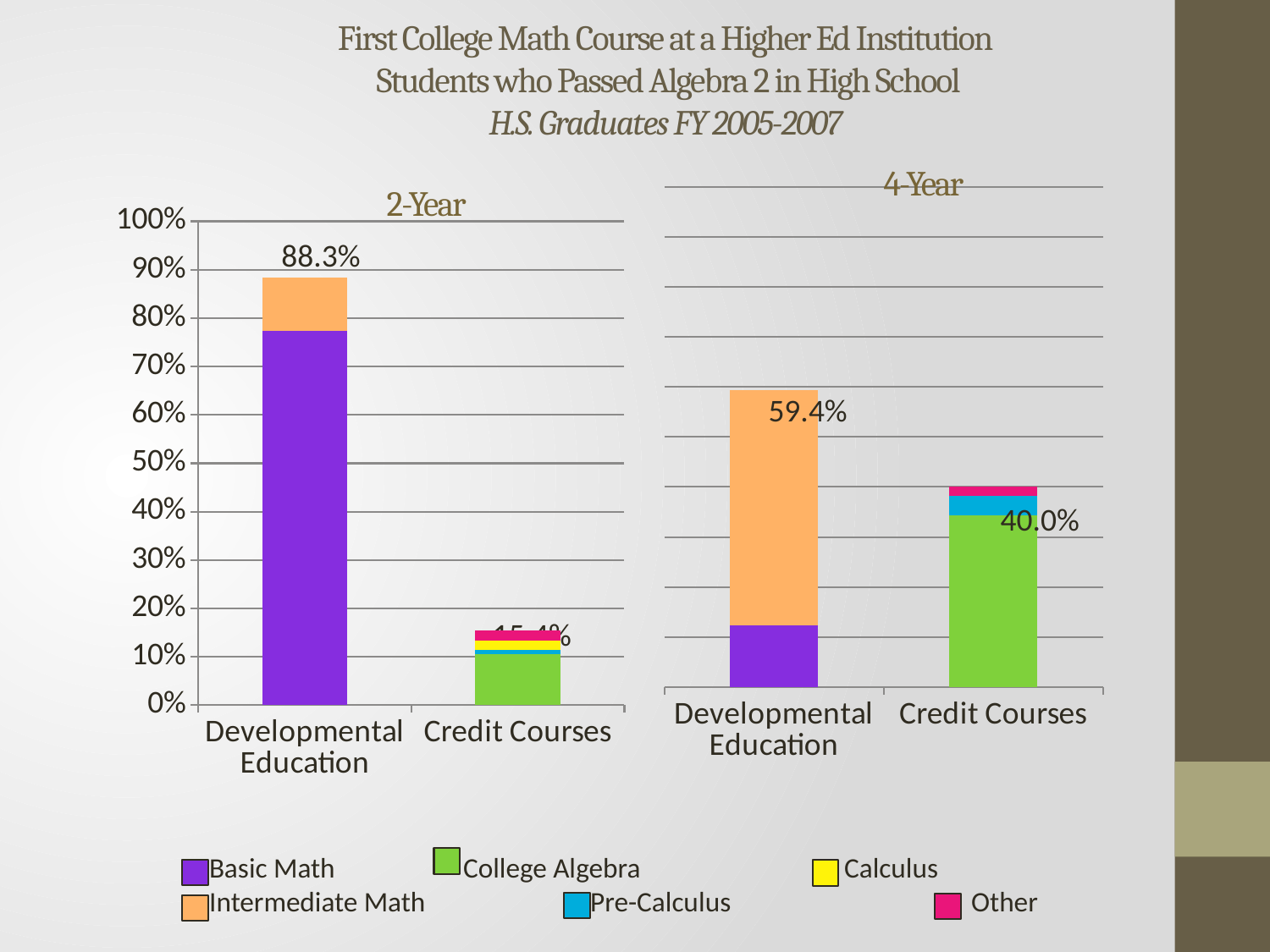
In the 4-Year chart, what is the value labelled for Developmental Education? 59.4% In the 2-Year chart, what is the total value labelled for Developmental Education? 88.3% In the 2-Year chart, is the total value for Credit Courses greater or less than 20%? less In the 4-Year chart, which category has the highest value? Developmental Education What kind of chart is the 2-Year chart? bar chart How many series does the legend list? 6 How many categories are shown on the x axis of the 2-Year chart? 2 In the 4-Year chart, what is the difference between the Developmental Education and Credit Courses values? 19.4% What colour represents Basic Math in the legend? purple In the 4-Year chart, what is the value labelled for Credit Courses? 40.0% How much higher is the Developmental Education value in the 2-Year chart than in the 4-Year chart? 28.9% In the 2-Year chart, which bar is taller: Developmental Education or Credit Courses? Developmental Education